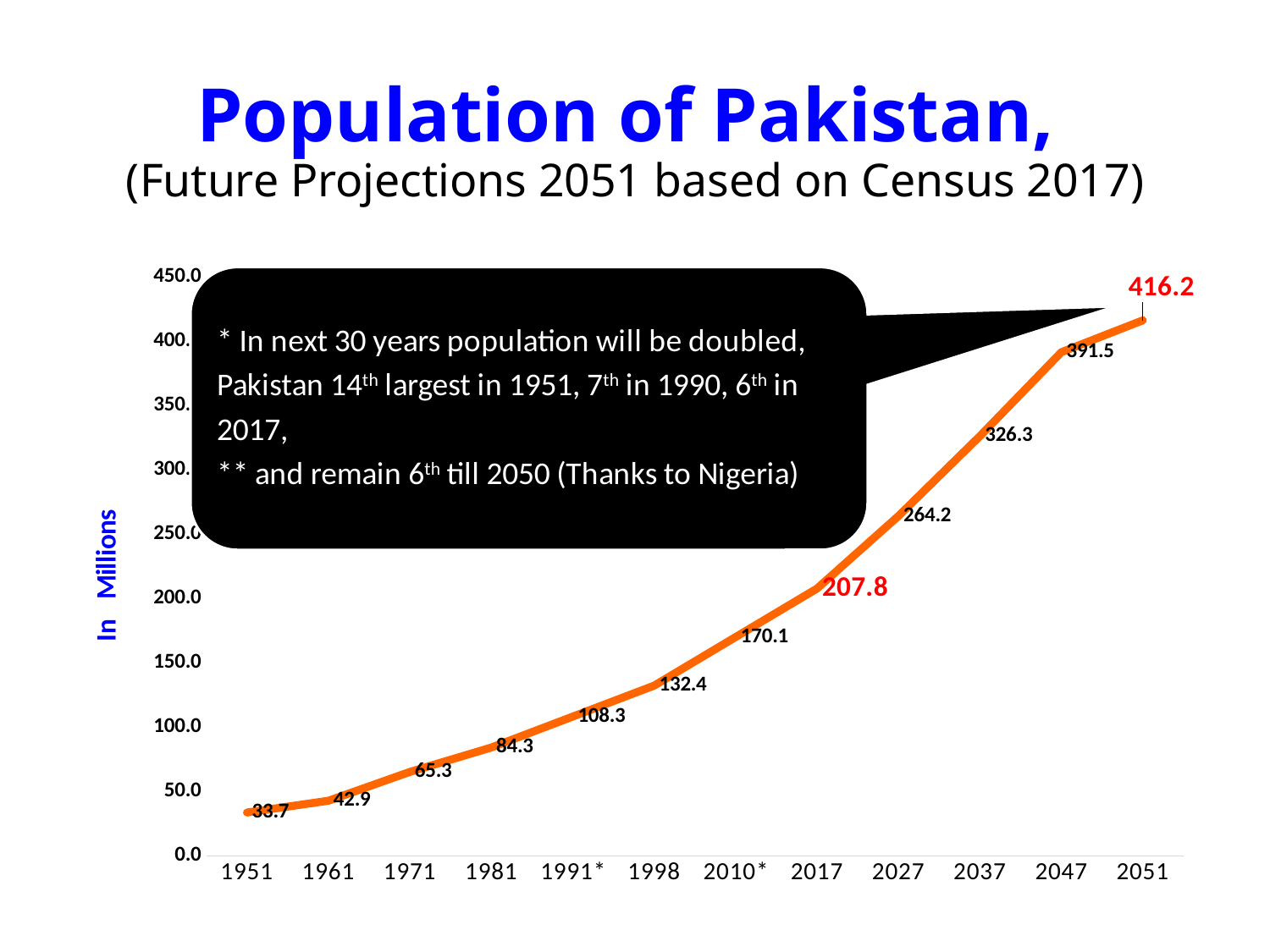
How many years are plotted on the x axis of the chart? 12 What is the population value shown for 1951? 33.7 What is the population value shown for 1998? 132.4 Which year has the highest population value on the chart? 2051 What is the difference between the population values for 2047 and 2037? 65.2 What is the population value shown for 2017? 207.8 Do the population values rise or fall from 1951 to 2051? rise What is the projected population value shown for 2051? 416.2 Which year has the lowest population value on the chart? 1951 What kind of chart is shown on the slide? line chart Is the population value for 2027 greater or less than 250.0? greater Which year has a larger population value, 1981 or 1991*? 1991*